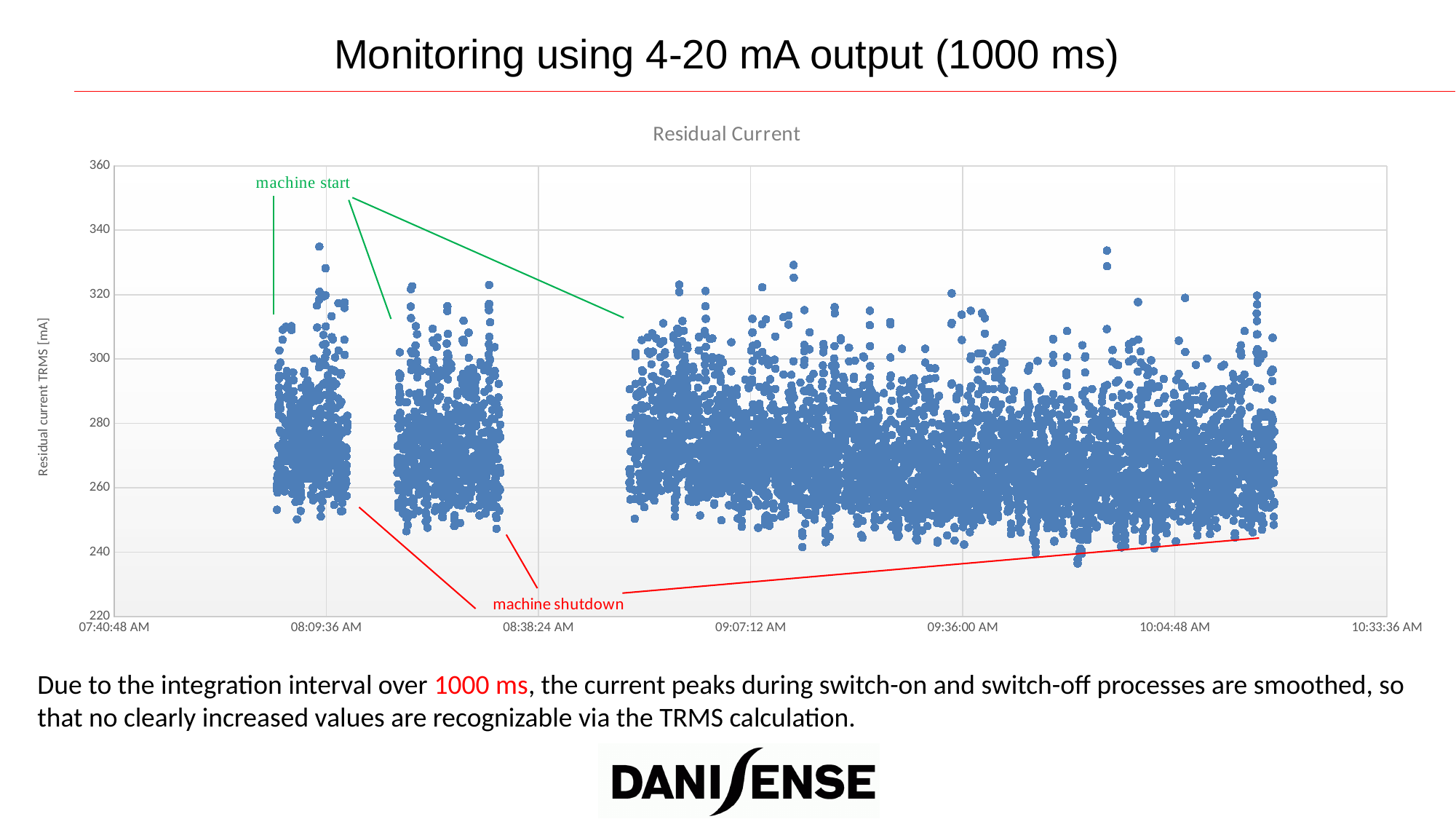
How many separate clusters (runs) of data points are plotted in the chart? 3 What is the label of the vertical axis of the chart? Residual current TRMS [mA] What is the first time label on the horizontal axis of the chart? 07:40:48 AM How many 'machine start' events are marked on the chart? 3 What is the highest value shown on the vertical axis of the chart? 360 Is the lowest plotted residual current value greater or less than 250 mA? less What is the title of the chart? Residual Current Is the highest plotted residual current value greater or less than 320 mA? greater What is the last time label on the horizontal axis of the chart? 10:33:36 AM What is the lowest value shown on the vertical axis of the chart? 220 How many 'machine shutdown' events are marked on the chart? 3 What kind of chart is shown on the slide? Scatter chart